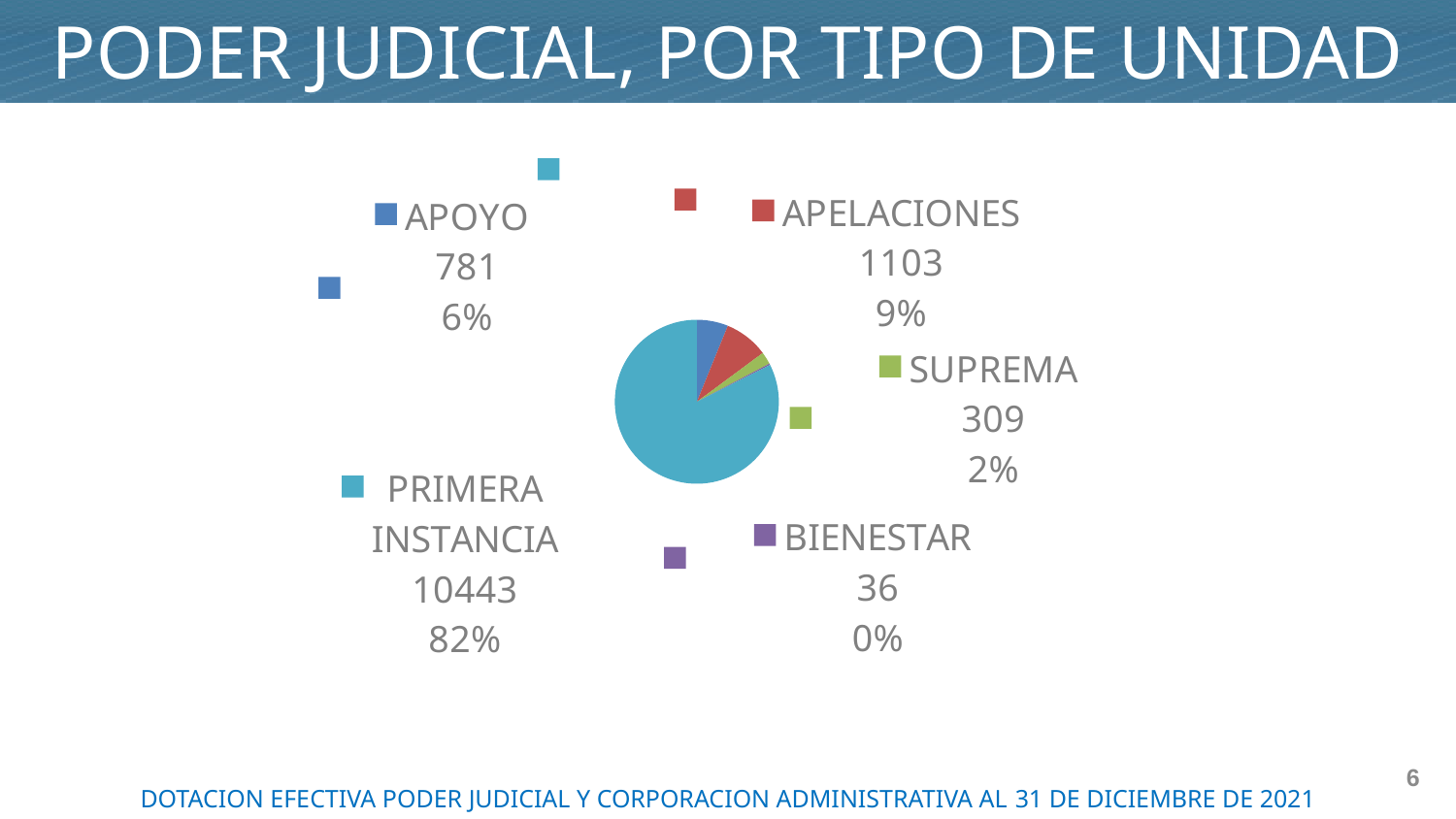
What is the value for BIENESTAR? 36 Which category has the largest value? PRIMERA INSTANCIA What is the difference between the values for APELACIONES and APOYO? 322 How many categories does the pie chart show? 5 What share of the pie does APOYO represent? 6% Which category has the smallest value? BIENESTAR What is the value for APELACIONES? 1103 Which is larger, the value for SUPREMA or the value for APOYO? APOYO What share of the pie does PRIMERA INSTANCIA represent? 82% What is the value for SUPREMA? 309 What type of chart is shown on the slide? pie chart What is the value for PRIMERA INSTANCIA? 10443